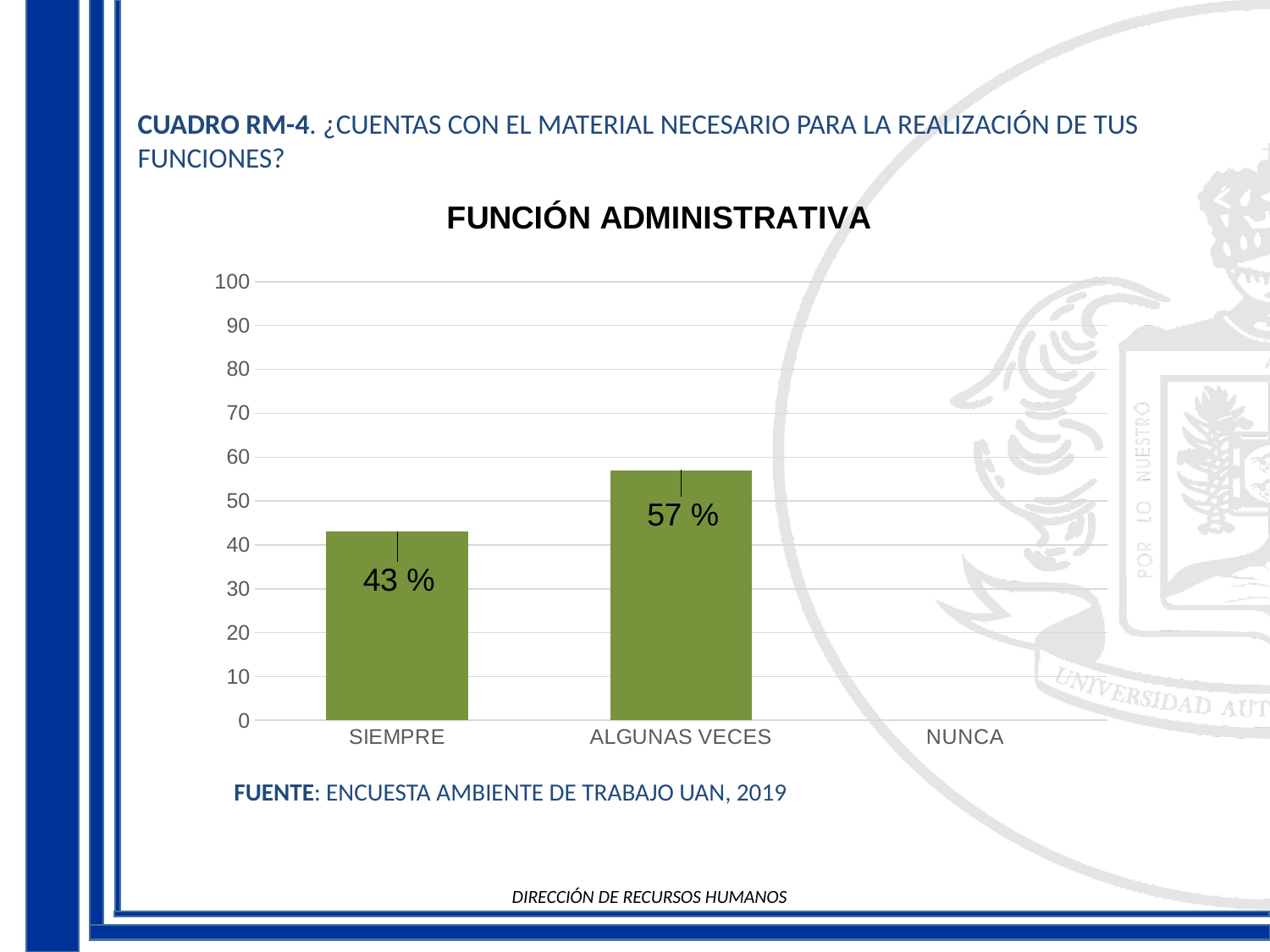
What is the value for ALGUNAS VECES? 57 % Which category has the highest value? ALGUNAS VECES What is the value for SIEMPRE? 43 % Which category has no visible bar? NUNCA Is the value for ALGUNAS VECES greater or less than 50? greater What is the title of the chart? FUNCIÓN ADMINISTRATIVA Is the value for SIEMPRE greater or less than 50? less Which is larger, the value for SIEMPRE or the value for ALGUNAS VECES? ALGUNAS VECES What is the difference between the values for ALGUNAS VECES and SIEMPRE? 14 % How many categories are shown on the x axis? 3 What kind of chart is shown on the slide? bar chart What is the highest value shown on the y axis? 100